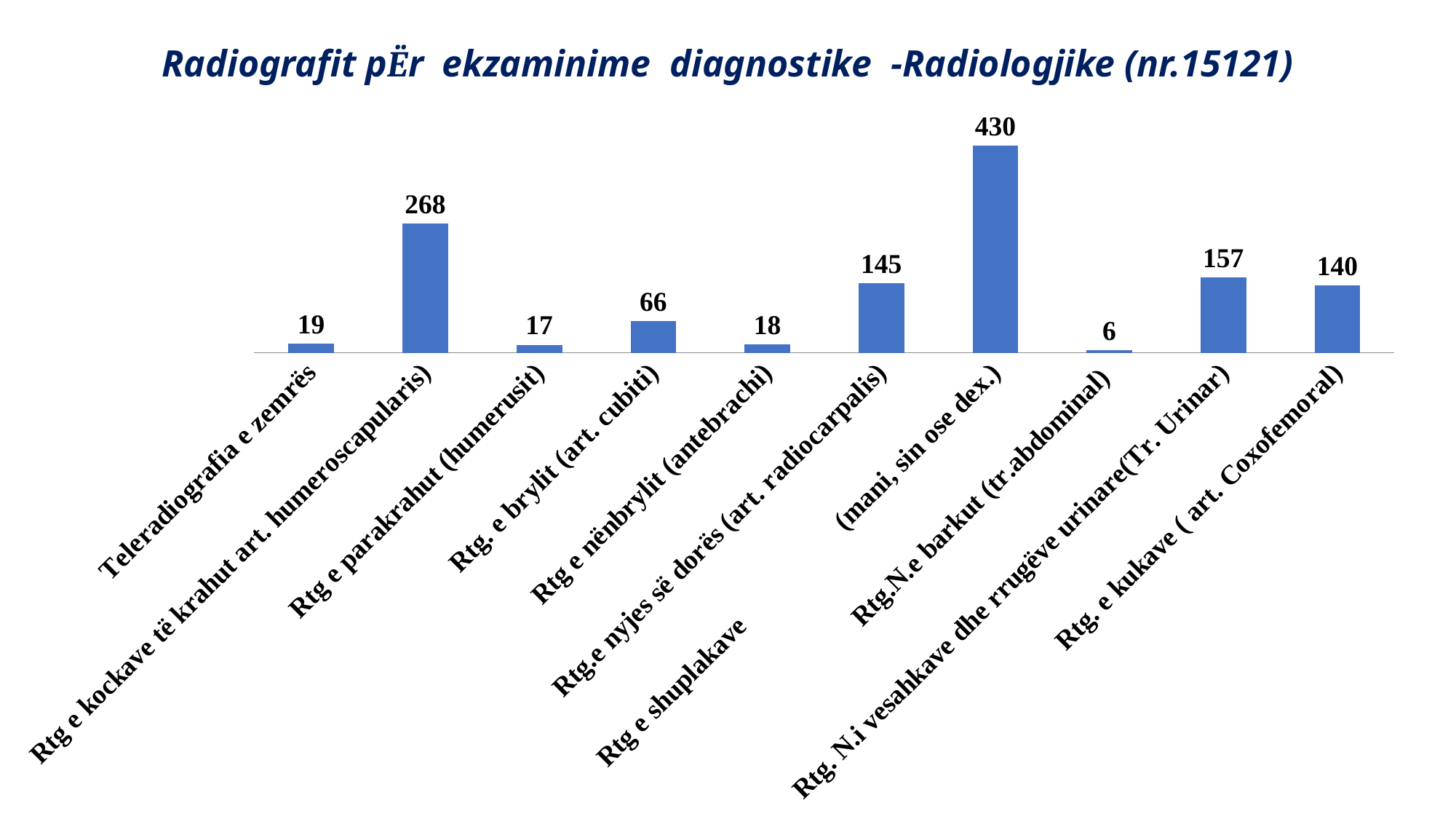
What is the difference between the values for Rtg e shuplakave (mani, sin ose dex.) and Rtg e kockave të krahut art. humeroscapularis)? 162 What is the value for Rtg. e kukave ( art. Coxofemoral)? 140 What is the value for Rtg. e brylit (art. cubiti)? 66 What is the value for Rtg e shuplakave (mani, sin ose dex.)? 430 What kind of chart is shown on the slide? Bar chart What number is given in parentheses in the chart title? nr.15121 Which is larger, the value for Rtg.e nyjes së dorës (art. radiocarpalis) or the value for Rtg. e brylit (art. cubiti)? Rtg.e nyjes së dorës (art. radiocarpalis) Which category has the lowest value? Rtg.N.e barkut (tr.abdominal) What is the difference between the values for Rtg. N.i vesahkave dhe rrugëve urinare(Tr. Urinar) and Rtg. e kukave ( art. Coxofemoral)? 17 How many categories are shown in the chart? 10 What is the value for Teleradiografia e zemrës? 19 Which category has the highest value? Rtg e shuplakave (mani, sin ose dex.)